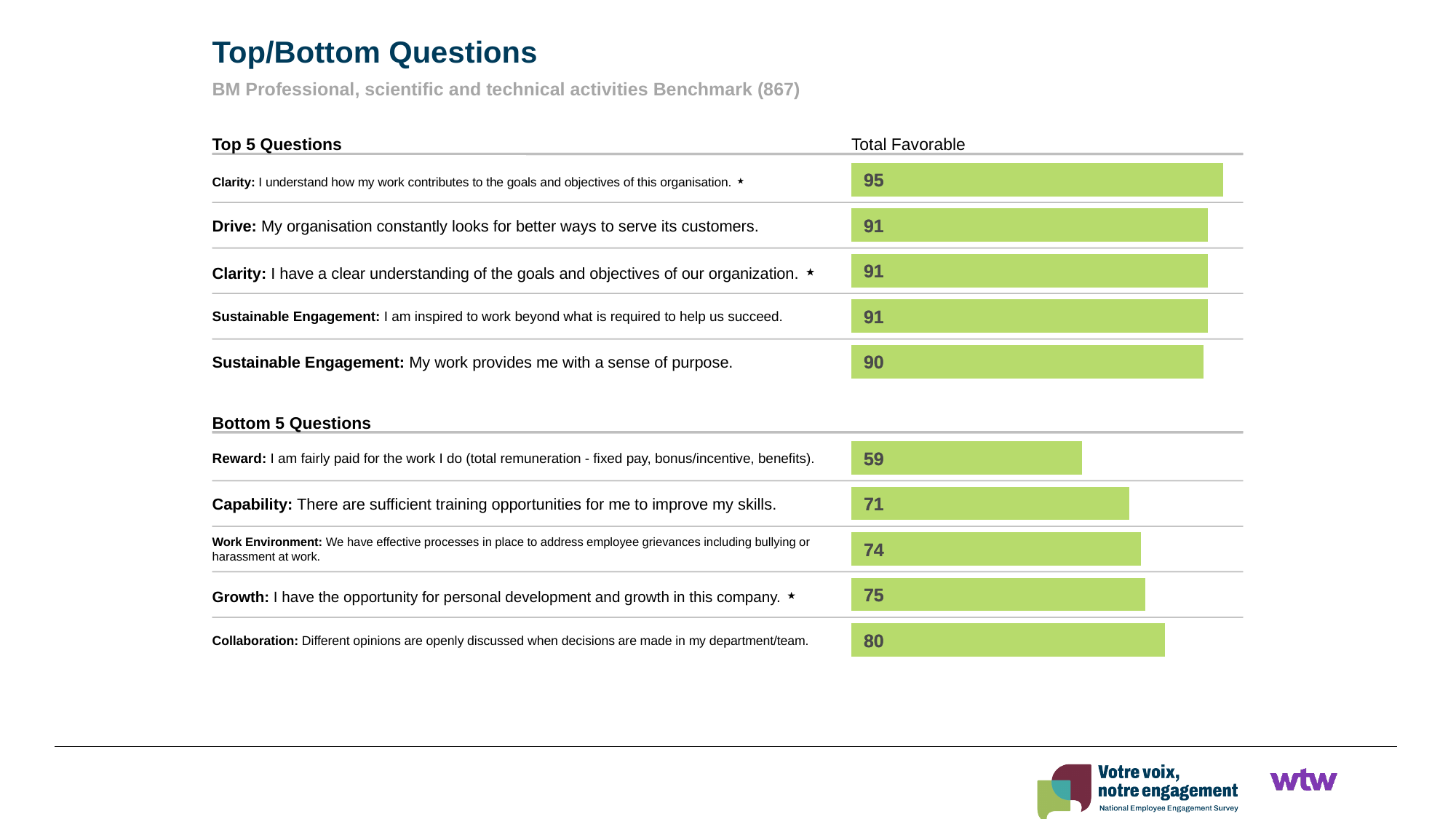
In the Top 5 Questions chart, which item has the highest Total Favorable value? Clarity: I understand how my work contributes to the goals and objectives of this organisation. In the Bottom 5 Questions chart, what is the difference between the Collaboration value and the Reward value? 21 In the Bottom 5 Questions chart, which is larger: the Capability value or the Growth value? Growth In the Bottom 5 Questions chart, what is the Total Favorable value for the Work Environment item? 74 What kind of chart is used to show the Total Favorable values? Bar chart In the Top 5 Questions chart, what is the Total Favorable value for the Drive item 'My organisation constantly looks for better ways to serve its customers'? 91 In the Bottom 5 Questions chart, which item has the lowest Total Favorable value? Reward: I am fairly paid for the work I do (total remuneration - fixed pay, bonus/incentive, benefits). In the Bottom 5 Questions chart, what is the Total Favorable value for the Reward item? 59 In the Bottom 5 Questions chart, what is the Total Favorable value for the Collaboration item? 80 In the Top 5 Questions chart, what is the difference between the highest value (95) and the lowest value (90)? 5 How many items are shown in the Bottom 5 Questions chart? 5 What is the column heading above the bars in the Top 5 Questions chart? Total Favorable